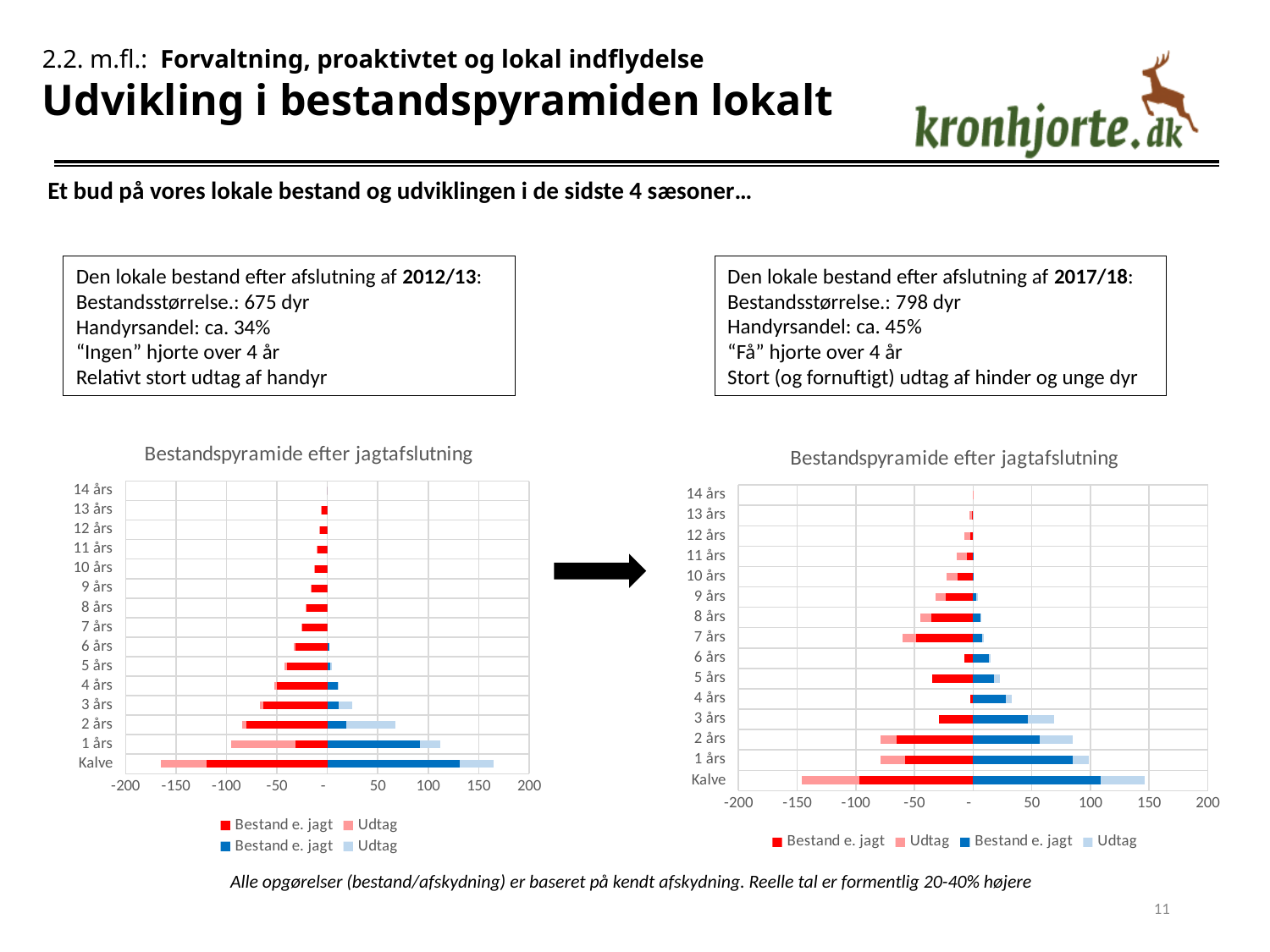
In the left chart, is the blue 'Bestand e. jagt' value for Kalve greater or less than 100? greater In the left chart, do the bar lengths generally increase or decrease as the age category goes from Kalve up to 14 års? decrease In the right chart, is the blue 'Bestand e. jagt' value for 4 års greater or less than 50? less How many series does the legend of the right chart list? 4 In the left chart, which age category has the longest blue 'Bestand e. jagt' bar? Kalve What is the title of the right chart? Bestandspyramide efter jagtafslutning What kind of chart is the left chart on the slide? bar chart In the right chart, is the blue 'Bestand e. jagt' value for 1 års greater or less than 100? less In the right chart, which age category has the longest blue 'Bestand e. jagt' bar? Kalve In the right chart, which has the longer blue 'Bestand e. jagt' bar: 1 års or 2 års? 1 års How many age categories are listed on the vertical axis of the left chart? 15 In the left chart, which has the longer blue 'Bestand e. jagt' bar: Kalve or 1 års? Kalve